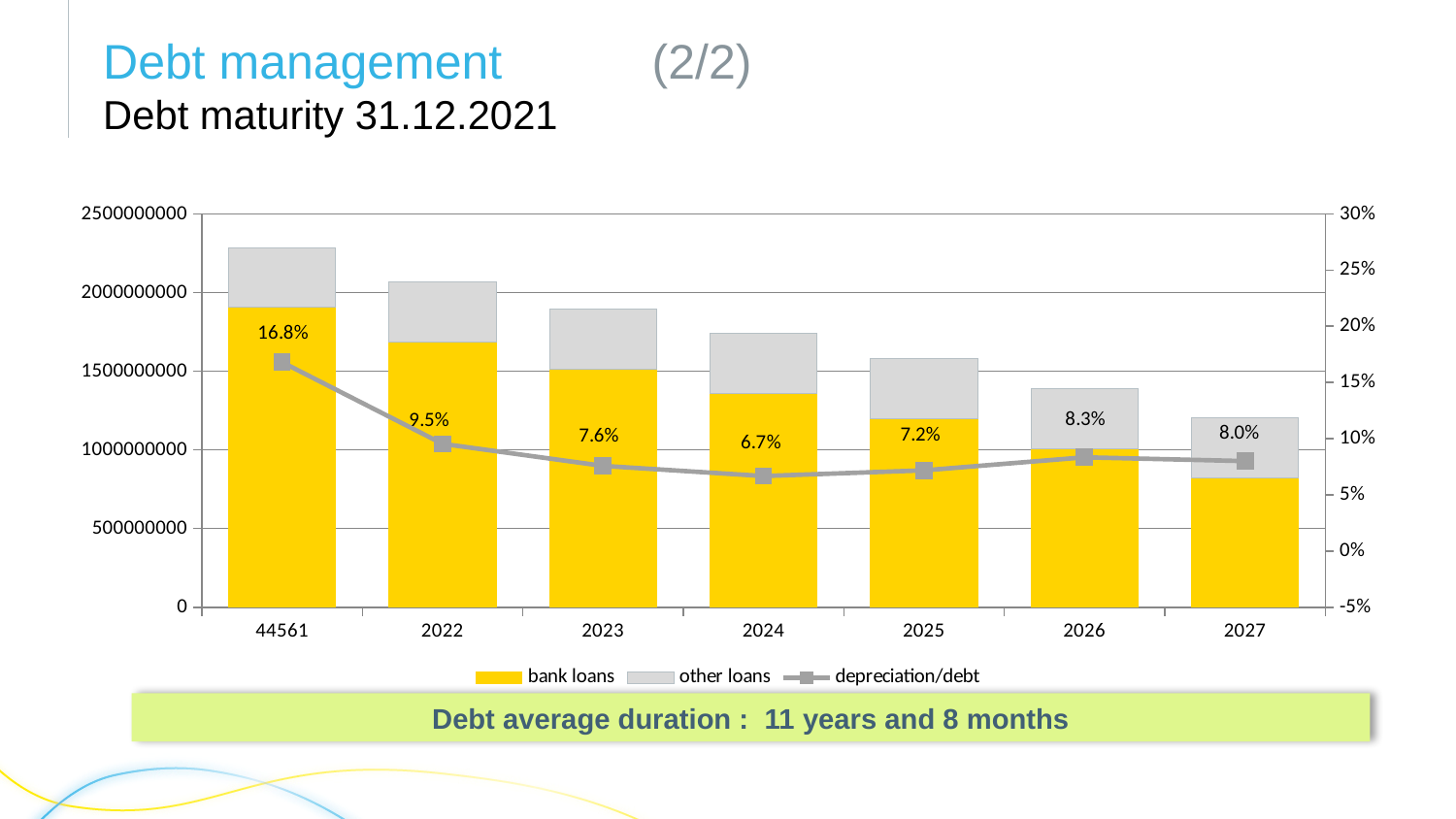
Is the total stacked bar for 44561 greater or less than 2000000000? greater What is the depreciation/debt value for 2023? 7.6% What is the depreciation/debt value for the first category, labelled 44561? 16.8% Does the depreciation/debt line rise or fall from 44561 to 2024? fall How many series does the legend list? 3 What is the difference between the depreciation/debt values for 44561 and 2022? 7.3 percentage points Which category has the lowest depreciation/debt value? 2024 Is the bank loans value for 2027 greater or less than 1000000000? less What kind of chart is this? Combined stacked bar and line chart Which has the larger depreciation/debt value, 2025 or 2026? 2026 Which category has the highest depreciation/debt value? 44561 How many categories are shown on the x axis? 7